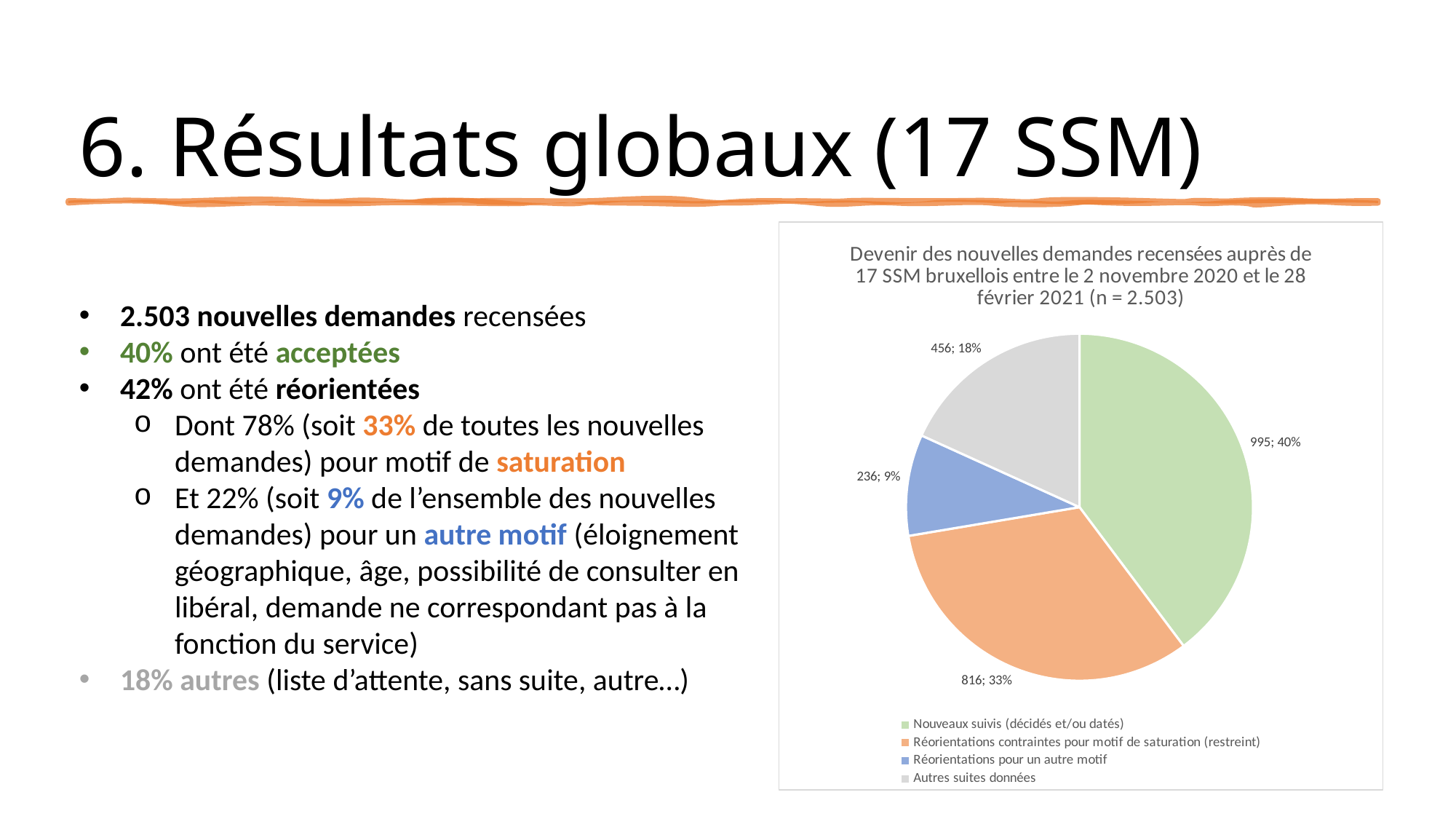
Which is larger in the pie chart: 'Autres suites données' or 'Réorientations pour un autre motif'? Autres suites données What is the value for 'Autres suites données' in the pie chart? 456 Which category has the largest slice in the pie chart? Nouveaux suivis (décidés et/ou datés) What kind of chart is shown on the slide? pie chart How many entries does the legend of the pie chart list? 4 How many slices does the pie chart have? 4 Which category has the smallest slice in the pie chart? Réorientations pour un autre motif What is the value for 'Réorientations pour un autre motif' in the pie chart? 236 What is the difference between the values for 'Nouveaux suivis (décidés et/ou datés)' and 'Autres suites données'? 539 What is the value for 'Réorientations contraintes pour motif de saturation (restreint)' in the pie chart? 816 What share of the pie does 'Réorientations contraintes pour motif de saturation (restreint)' represent? 33% What is the value for 'Nouveaux suivis (décidés et/ou datés)' in the pie chart? 995